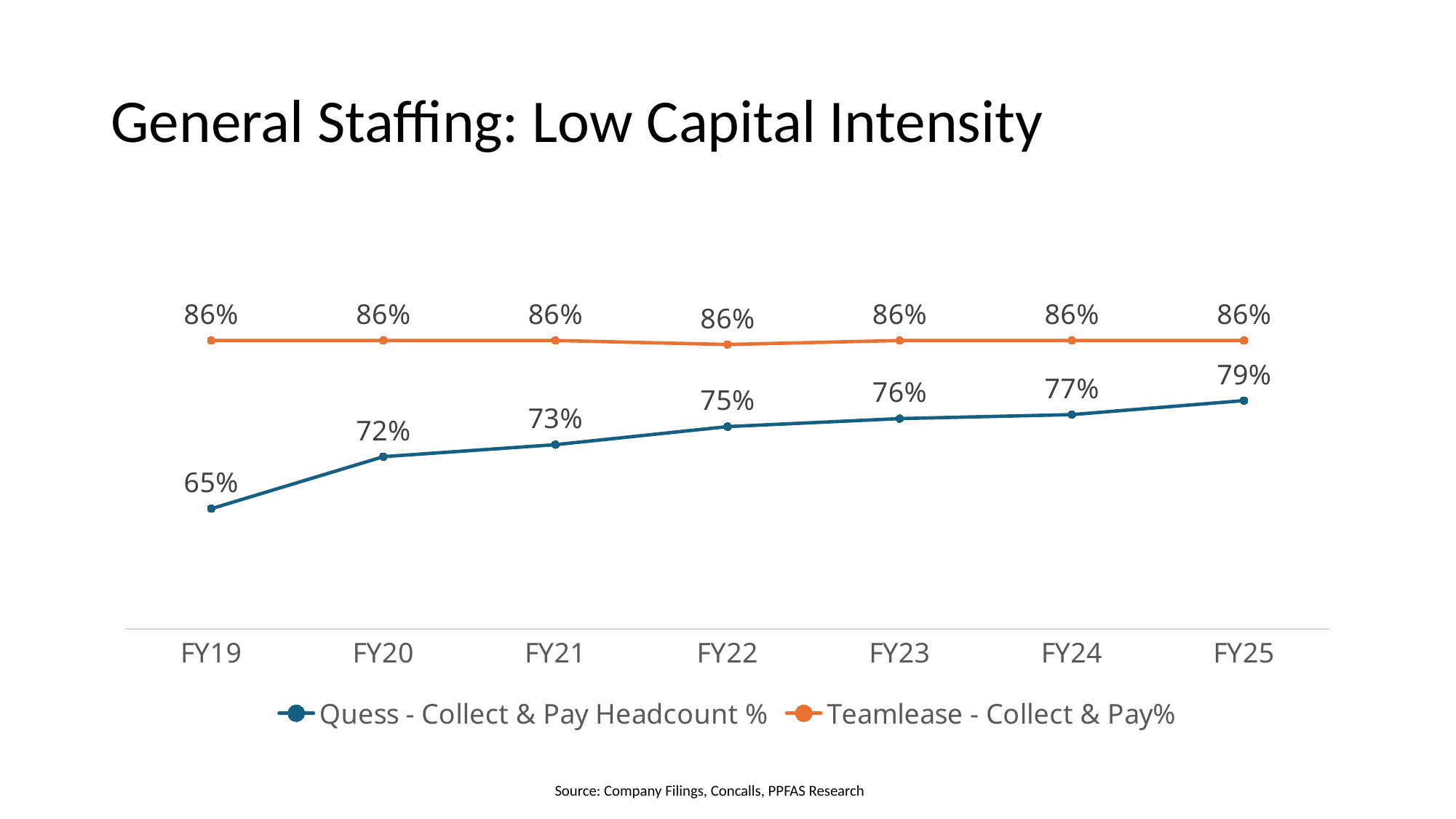
What is the difference between the Teamlease - Collect & Pay% and the Quess - Collect & Pay Headcount % in FY19? 21% What is the Quess - Collect & Pay Headcount % value for FY22? 75% How many fiscal years are shown on the x axis? 7 Which series has the higher value in FY24, Quess - Collect & Pay Headcount % or Teamlease - Collect & Pay%? Teamlease - Collect & Pay% In which fiscal year is the Quess - Collect & Pay Headcount % highest? FY25 In which fiscal year is the Quess - Collect & Pay Headcount % lowest? FY19 What is the Teamlease - Collect & Pay% value for FY22? 86% What is the Quess - Collect & Pay Headcount % value for FY25? 79% By how much did the Quess - Collect & Pay Headcount % increase from FY19 to FY25? 14% What kind of chart is shown on the slide? Line chart How many series does the legend list? 2 What is the Quess - Collect & Pay Headcount % value for FY19? 65%